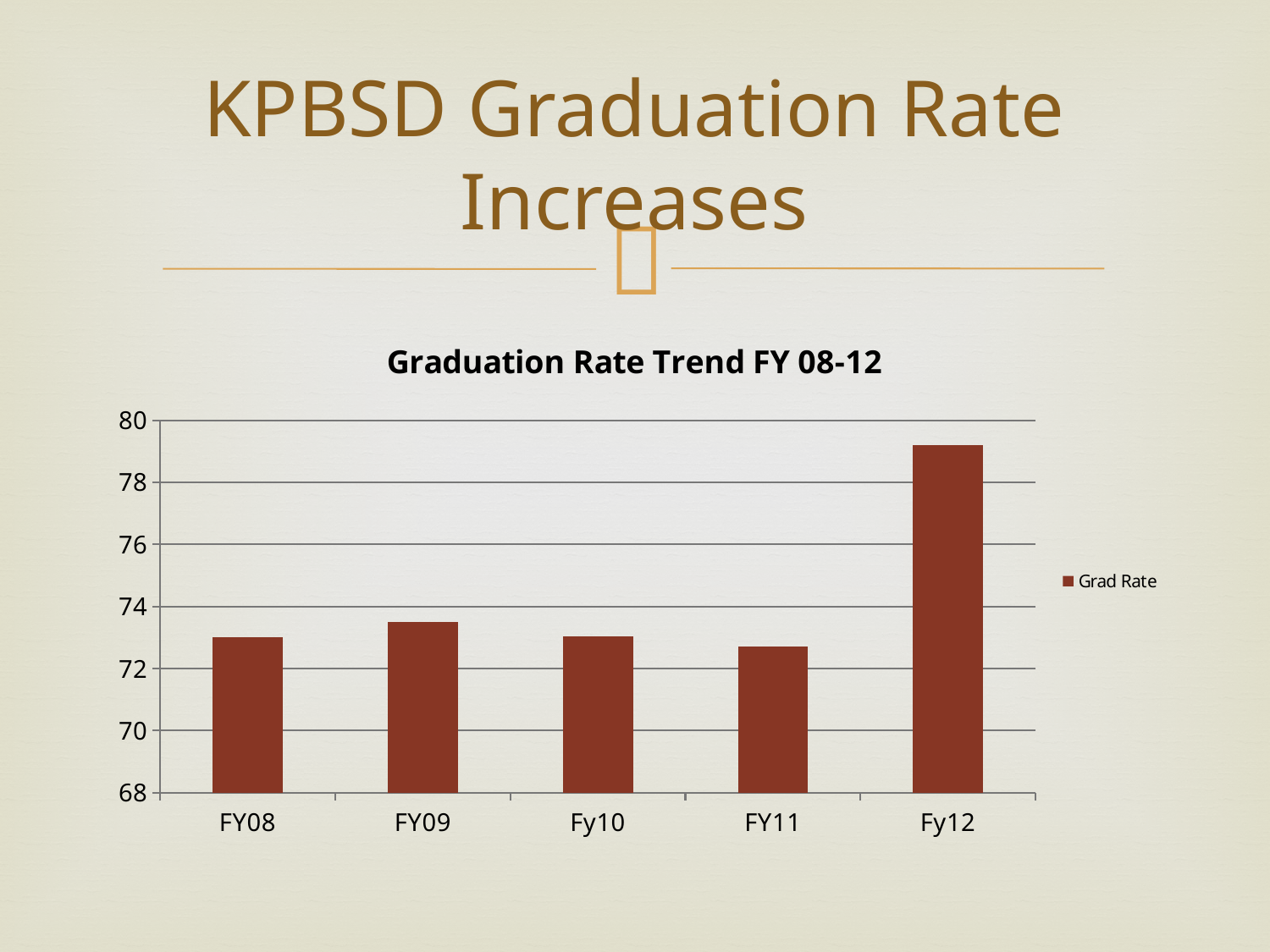
Is the value for FY09 greater or less than 76? less What is the title of the chart? Graduation Rate Trend FY 08-12 What is the name of the series shown in the legend? Grad Rate Is the value for FY08 greater or less than 74? less What type of chart is shown on the slide? bar chart Does the graduation rate rise or fall from FY11 to Fy12? rise Is the value for Fy12 greater or less than 78? greater Which is larger, the value for FY09 or the value for FY11? FY09 Which fiscal year has the highest graduation rate? Fy12 How many fiscal years are shown on the x axis? 5 How many series does the legend list? 1